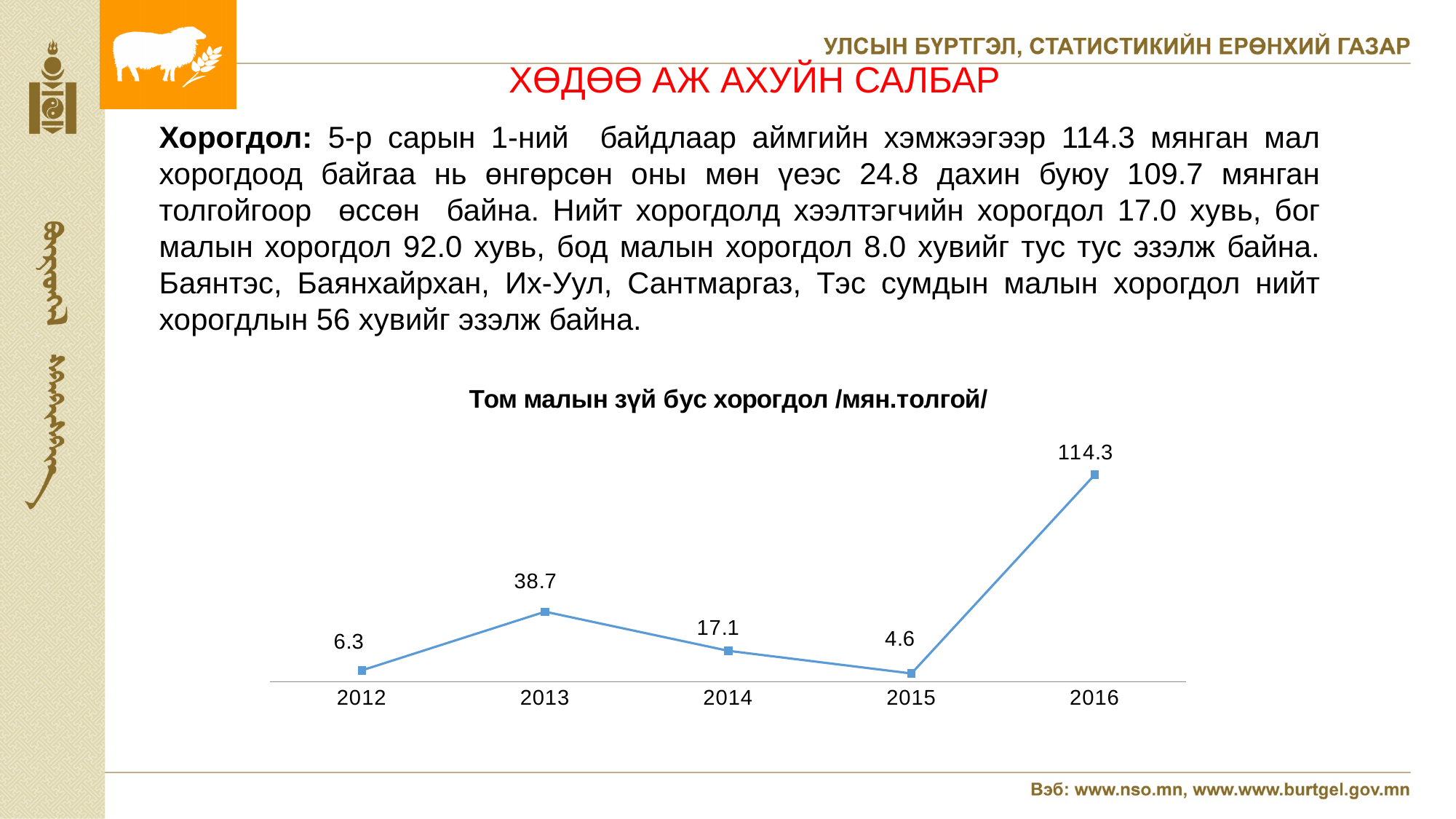
Which is larger, the value for 2013 or the value for 2014? 2013 What is the value for 2015? 4.6 What is the value for 2013? 38.7 What is the value for 2012? 6.3 What is the difference between the values for 2013 and 2014? 21.6 Which year has the highest value? 2016 What kind of chart is shown? line chart How many years are plotted on the chart? 5 What is the difference between the values for 2016 and 2015? 109.7 Which year has the lowest value? 2015 What is the value for 2016? 114.3 What is the title of the chart? Том малын зүй бус хорогдол /мян.толгой/